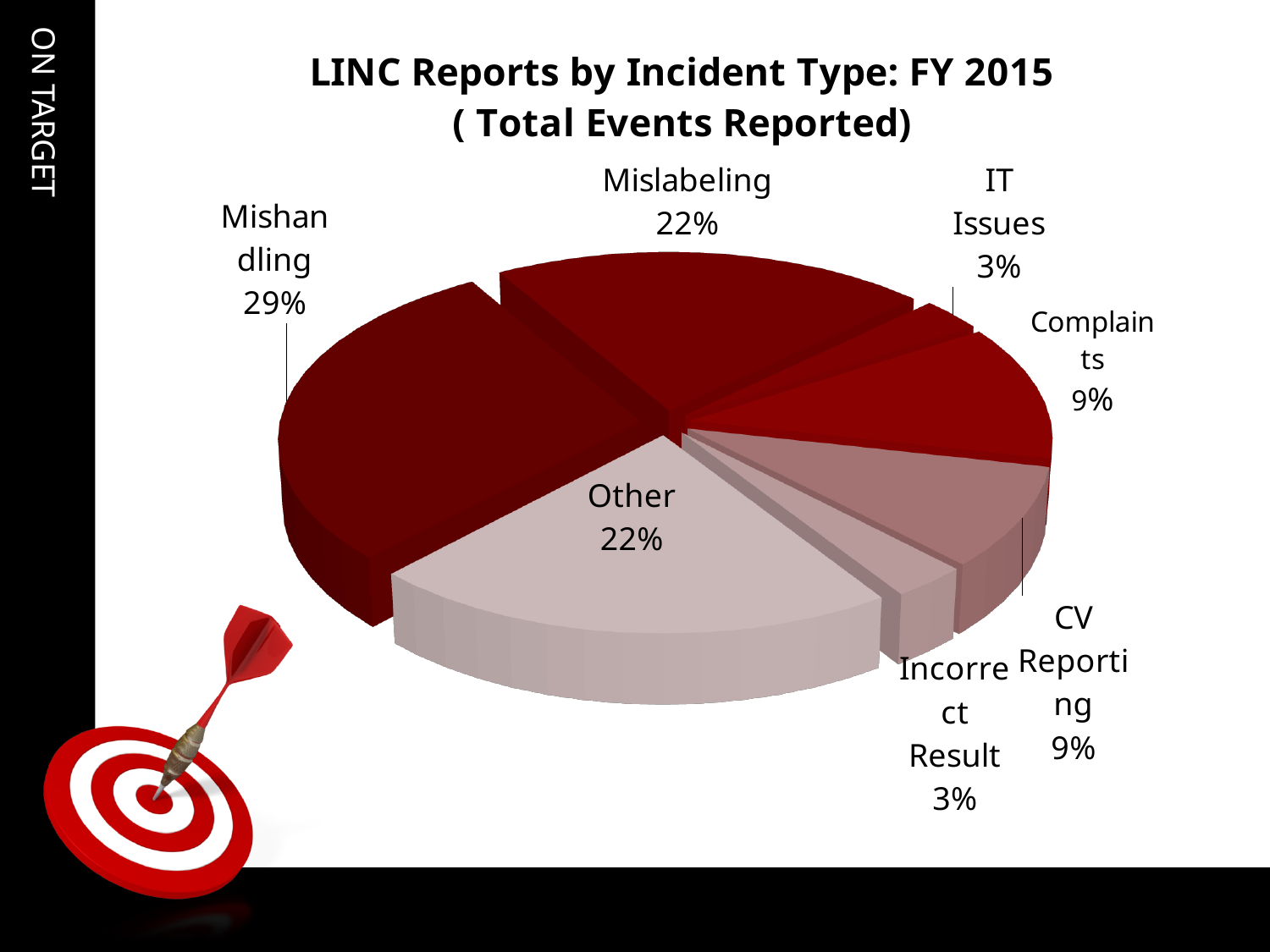
What percentage is shown for IT Issues? 3% What percentage of reports is labeled Mislabeling? 22% What is the value shown for Complaints? 9% What share of LINC reports is attributed to Mishandling? 29% Which is larger, the share for Complaints or the share for Incorrect Result? Complaints What is the combined share of Mislabeling and Other? 44% Which incident type has the largest share of the pie? Mishandling How many incident types are shown in the pie chart? 7 What is the title of the chart? LINC Reports by Incident Type: FY 2015 ( Total Events Reported) Which incident types share the smallest slice of the pie? IT Issues and Incorrect Result What kind of chart is shown on the slide? Pie chart What is the difference in percentage points between Mishandling and Mislabeling? 7